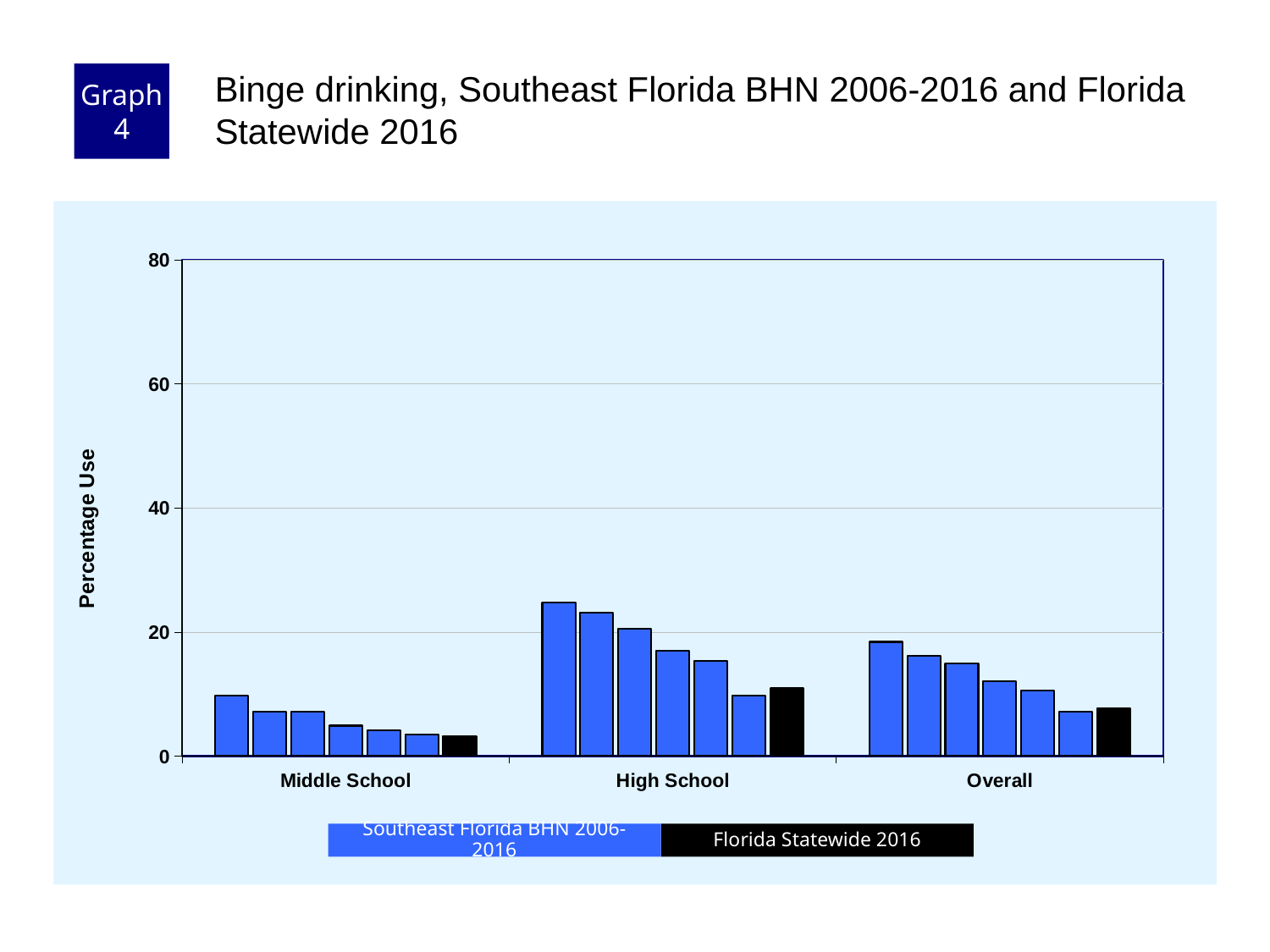
Which category has the lowest bars overall? Middle School What is the label on the y axis? Percentage Use What colour are the Florida Statewide 2016 bars? black Which category has the tallest bar? High School Is the Florida Statewide 2016 bar for Middle School greater or less than 20? less Is the tallest bar in the High School group greater or less than 20? greater Within each category, do the Southeast Florida BHN 2006-2016 bars rise or fall from left to right? fall How many categories are shown on the x axis? 3 How many series does the legend list? 2 Is the Florida Statewide 2016 bar for High School greater or less than 40? less What kind of chart is shown on the slide? bar chart Which is larger: the Florida Statewide 2016 bar for High School or the Florida Statewide 2016 bar for Middle School? High School